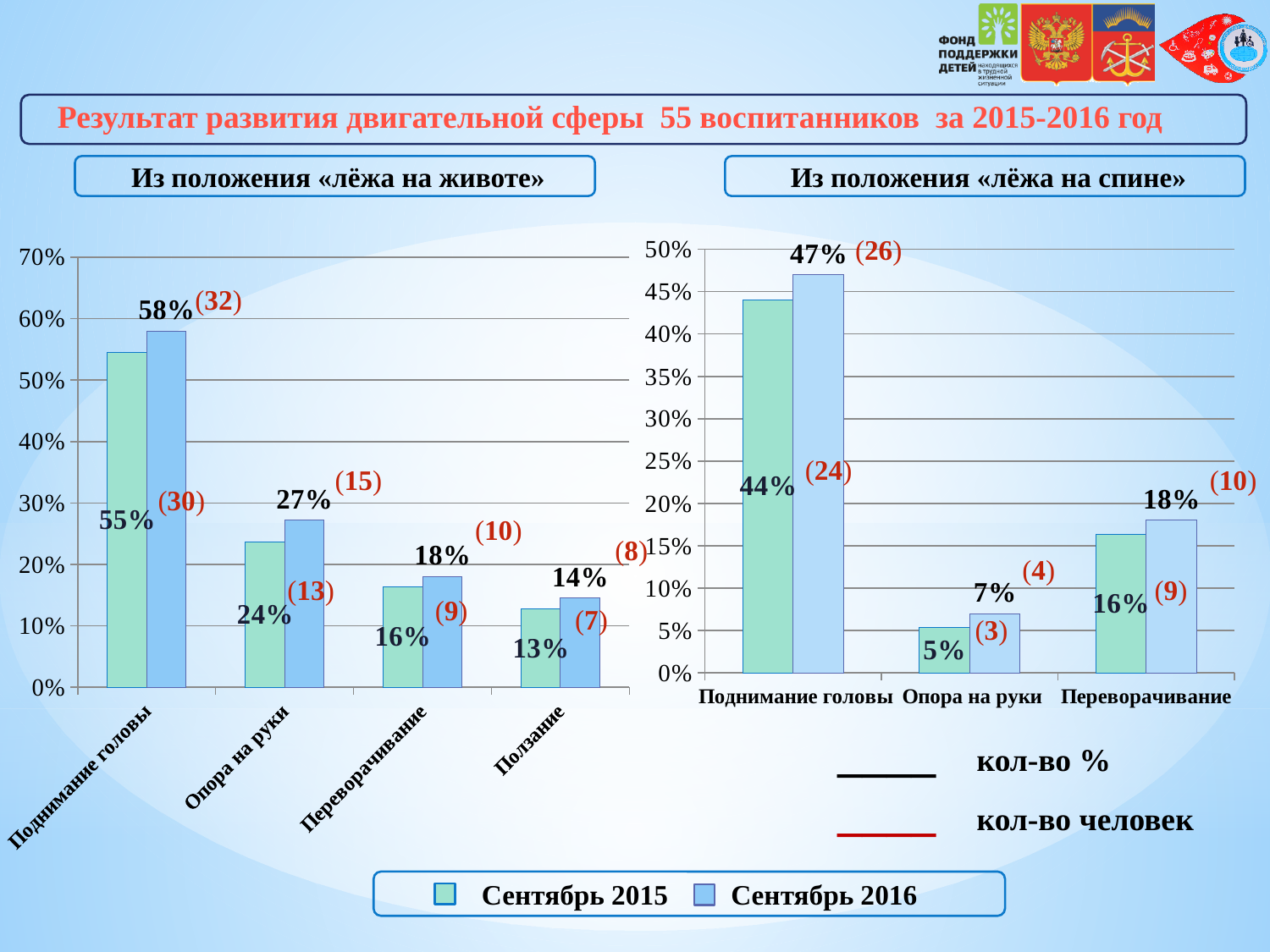
How many series does the legend at the bottom of the slide list? 2 In the chart «Из положения «лёжа на спине»», what is the value for Опора на руки in Сентябрь 2016? 7% In the chart «Из положения «лёжа на спине»», which is larger for Переворачивание: the Сентябрь 2015 value or the Сентябрь 2016 value? Сентябрь 2016 In the chart «Из положения «лёжа на животе»», what is the difference between the Сентябрь 2016 and Сентябрь 2015 values for Опора на руки? 3% In the chart «Из положения «лёжа на животе»», which category has the highest value in Сентябрь 2016? Поднимание головы How many categories are shown on the x axis of the chart «Из положения «лёжа на животе»»? 4 What type of chart is «Из положения «лёжа на спине»»? Bar chart In the chart «Из положения «лёжа на животе»», what is the value for Ползание in Сентябрь 2015? 13% In the chart «Из положения «лёжа на животе»», what is the value for Поднимание головы in Сентябрь 2016? 58% In the chart «Из положения «лёжа на спине»», which category has the lowest value in Сентябрь 2015? Опора на руки How many categories are shown on the x axis of the chart «Из положения «лёжа на спине»»? 3 In the chart «Из положения «лёжа на спине»», how many people does the label in parentheses show for Поднимание головы in Сентябрь 2016? 26